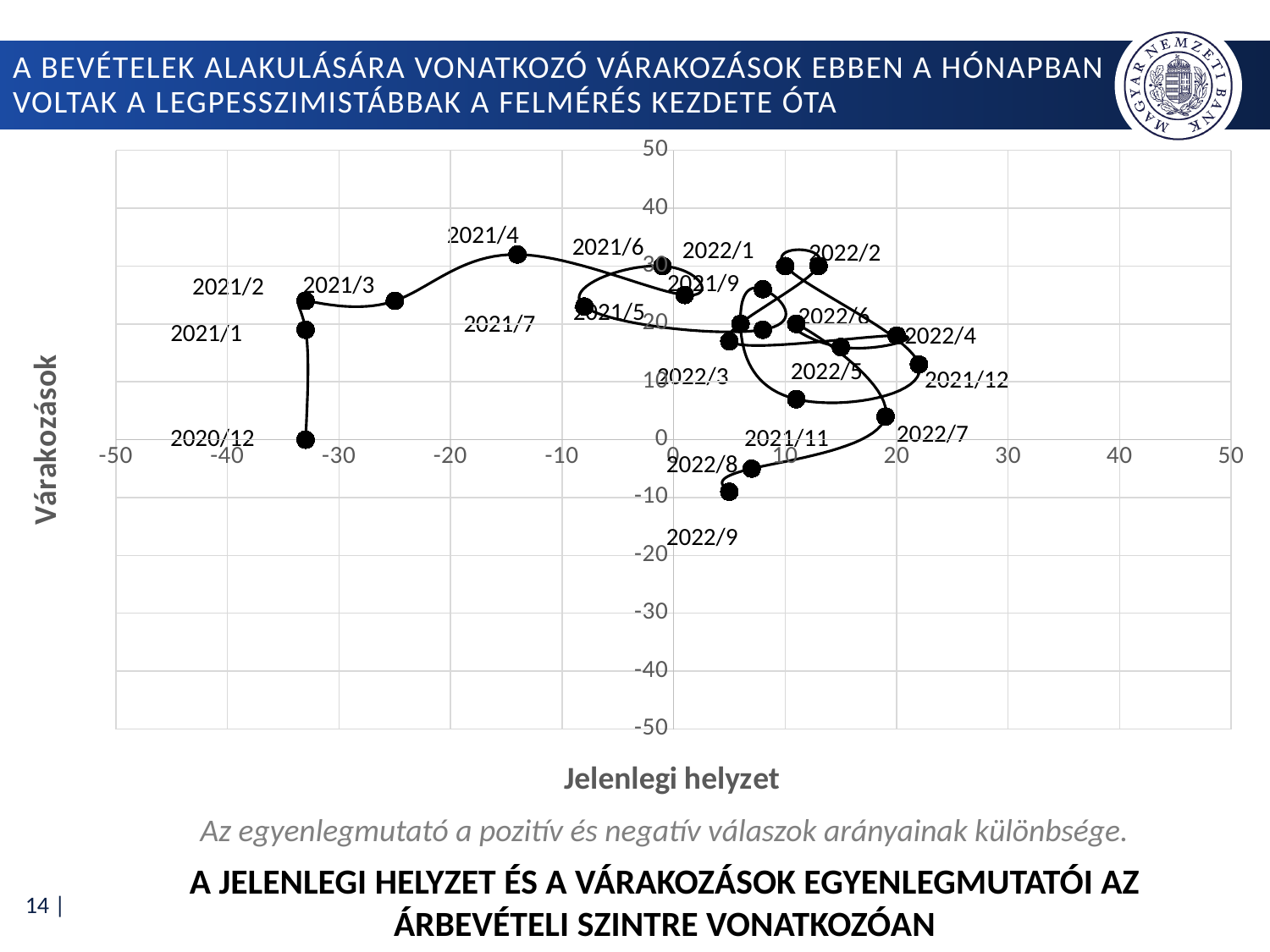
Which labelled point has the lowest value on the vertical axis (Várakozások)? 2022/9 Is the Jelenlegi helyzet value for 2021/4 greater or less than -10? less What is the title of the horizontal axis of the chart? Jelenlegi helyzet What is the title of the vertical axis of the chart? Várakozások Which point has the higher Várakozások value, 2021/4 or 2022/7? 2021/4 Is the Jelenlegi helyzet value for 2020/12 greater or less than -30? less Is the Várakozások value for 2022/9 greater or less than 0? less Which point has the larger Jelenlegi helyzet value, 2021/3 or 2022/4? 2022/4 What kind of chart is shown on the slide? scatter chart